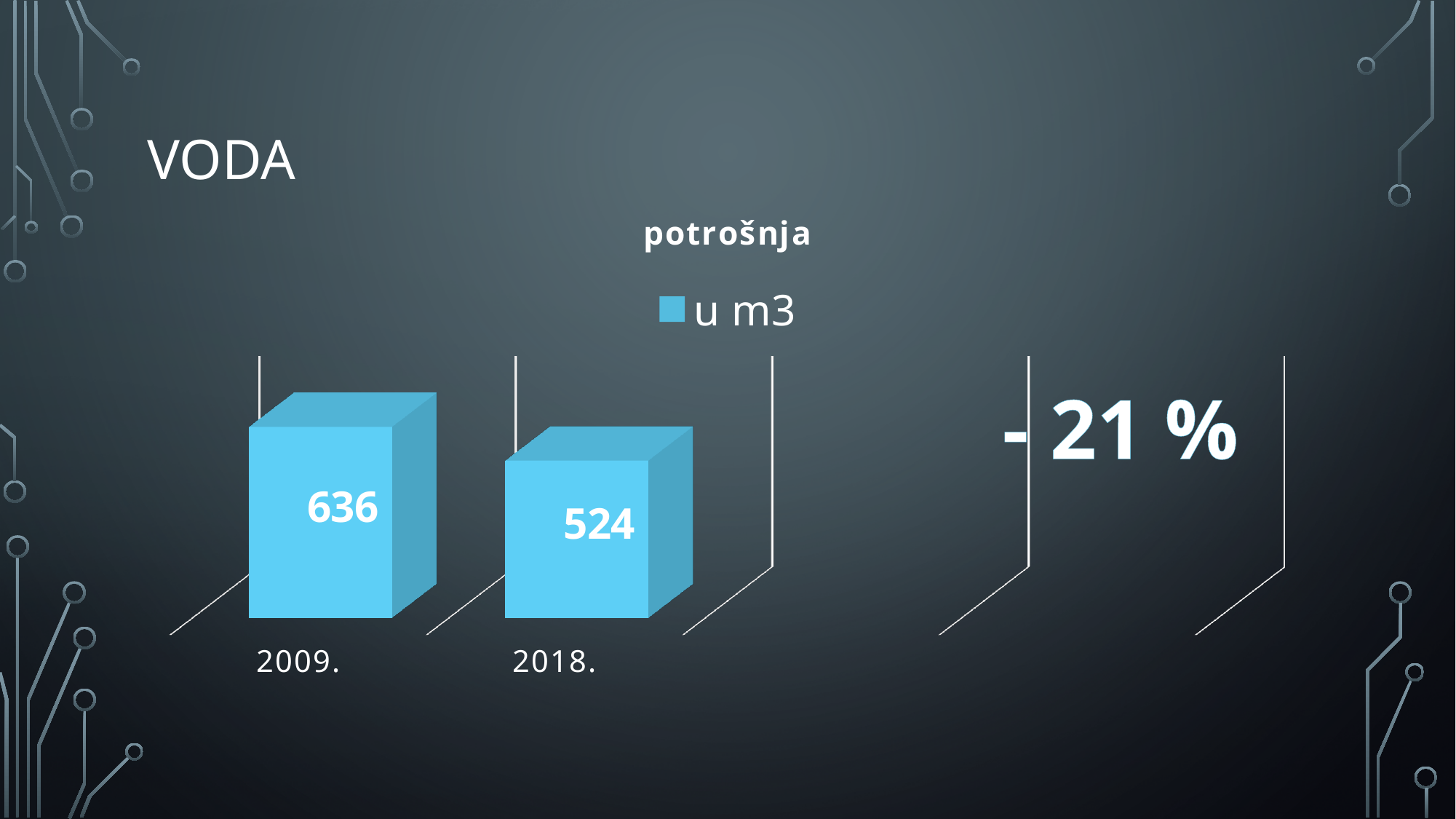
How many categories are shown on the x axis of the chart? 2 How many series does the legend list? 1 Is the value for 2009. larger or smaller than the value for 2018.? larger What is the title of the chart? potrošnja Which year has the lower value in the chart? 2018. What is the legend entry of the chart? u m3 Do the values rise or fall from 2009. to 2018.? fall What is the value for 2018. in the chart? 524 What kind of chart is shown on the slide? bar chart What is the value for 2009. in the chart? 636 Which year has the higher value in the chart? 2009. What is the difference between the values for 2009. and 2018.? 112